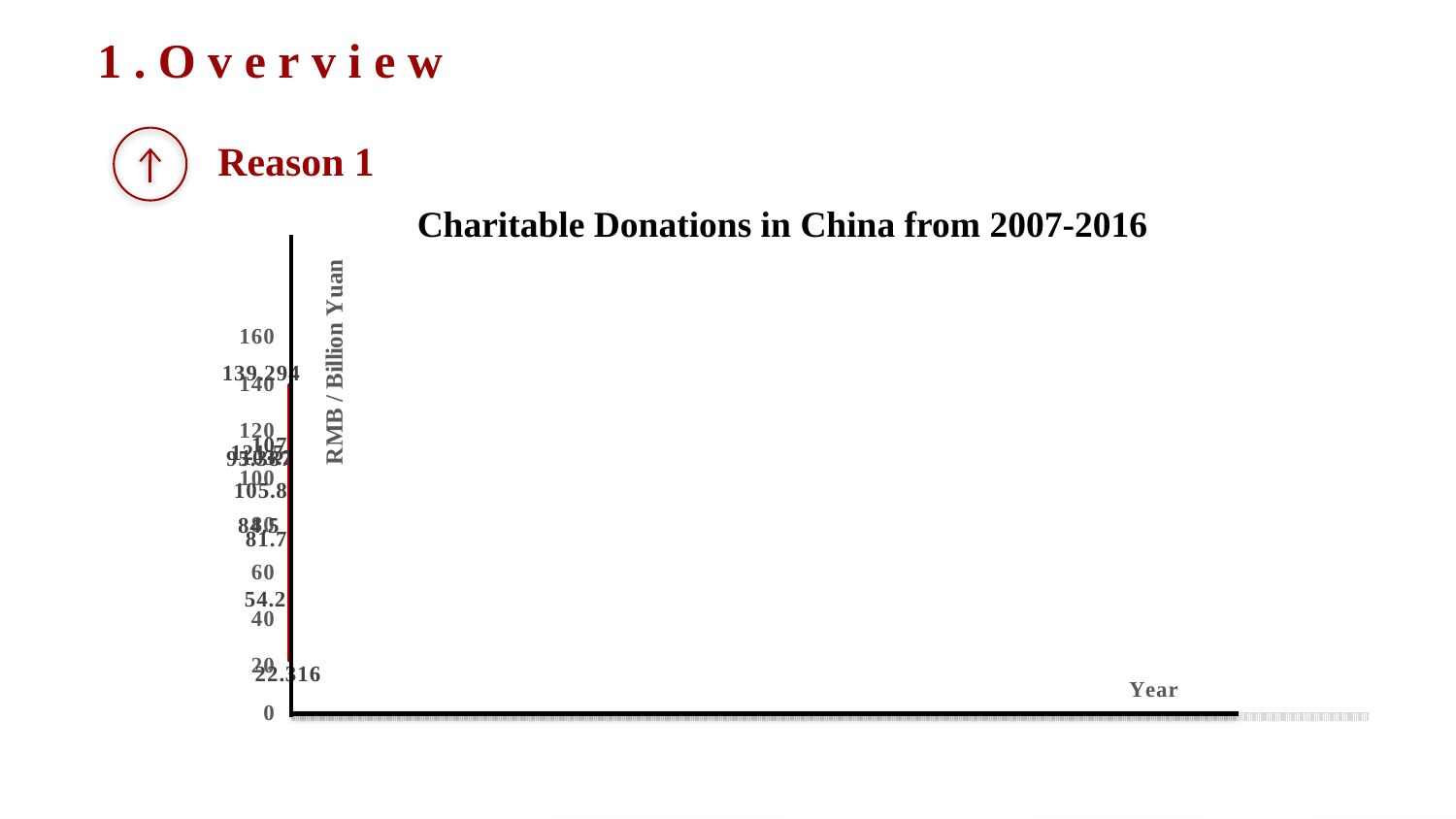
What is the smallest data label value shown on the chart? 22.316 What is the title of the chart? Charitable Donations in China from 2007-2016 What is the largest data label value shown on the chart? 139.294 Is the smallest labelled value on the chart greater or less than 40? less Is the largest labelled value on the chart greater or less than 120? greater What unit is shown on the vertical axis label of the chart? RMB / Billion Yuan